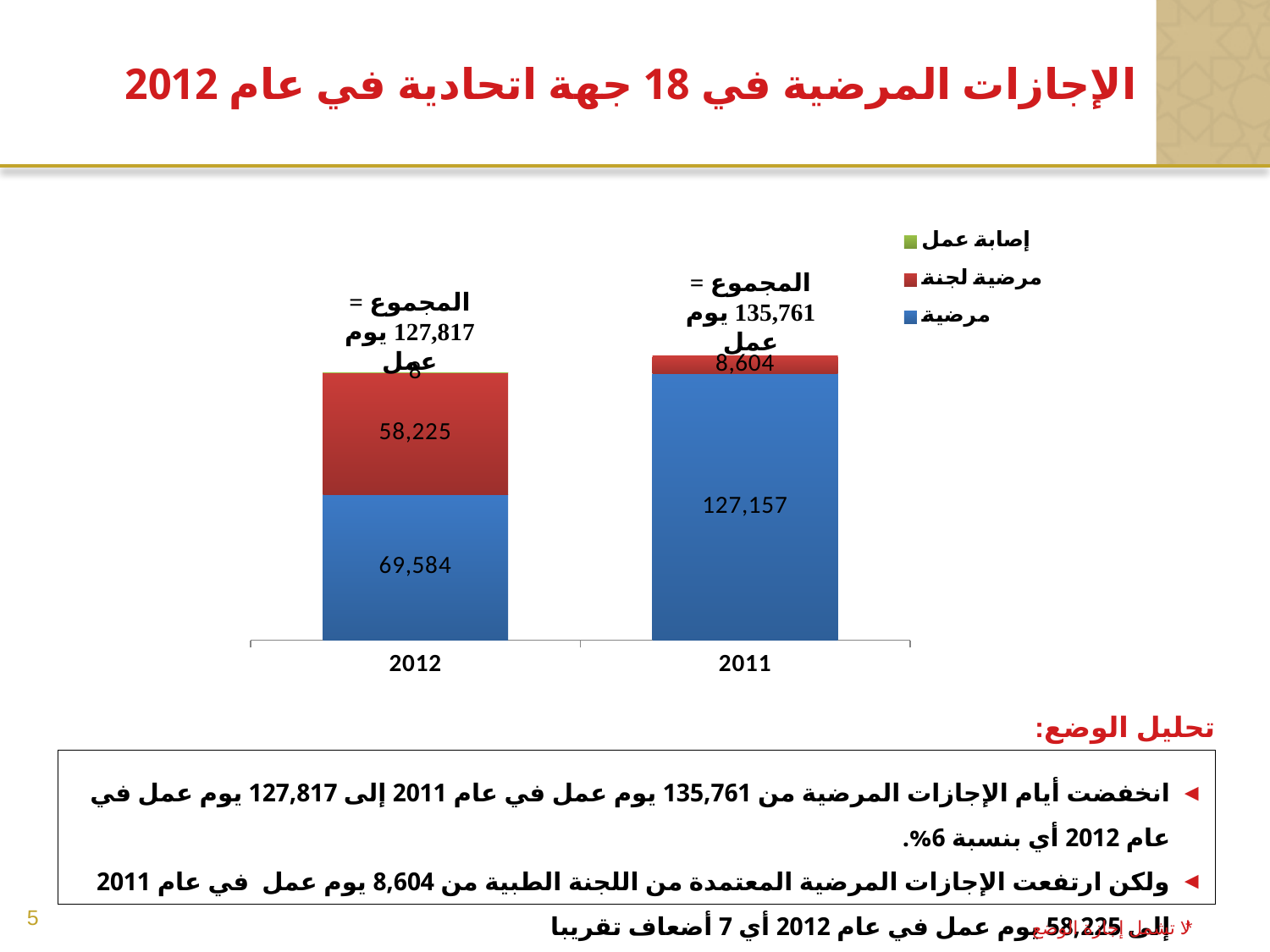
How many series does the legend list? 3 What is the difference between the مرضية values for 2011 and 2012? 57,573 What is the total of the stacked bar for 2012, as printed on the slide? 127,817 يوم عمل What is the value of the مرضية series for 2012? 69,584 Which series is shown in blue in the legend? مرضية What kind of chart is shown on the slide? stacked bar chart What is the value of the مرضية لجنة series for 2012? 58,225 What is the total of the stacked bar for 2011, as printed on the slide? 135,761 يوم عمل How many categories (years) are shown on the x axis? 2 Which year has the larger مرضية لجنة value, 2011 or 2012? 2012 What is the value of the مرضية series for 2011? 127,157 What is the value of the مرضية لجنة series for 2011? 8,604